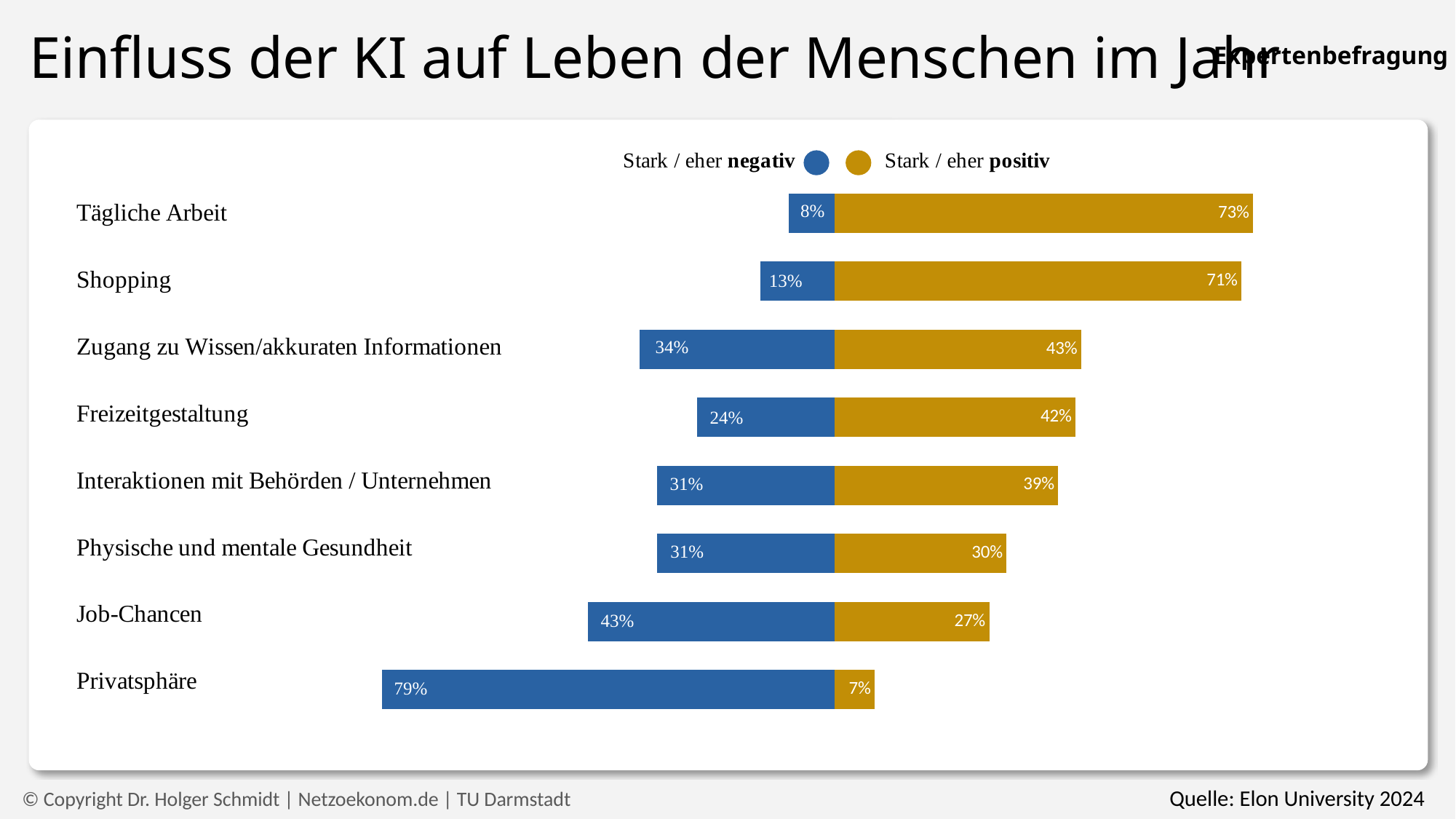
Which category has the lowest 'Stark / eher negativ' value? Tägliche Arbeit What is the 'Stark / eher positiv' value for Tägliche Arbeit? 73% What is the difference between the 'Stark / eher negativ' and 'Stark / eher positiv' values for Job-Chancen? 16% How many categories are shown in the chart? 8 What kind of chart is shown on the slide? Bar chart Which category has the lowest 'Stark / eher positiv' value? Privatsphäre Which is larger for Freizeitgestaltung: the 'Stark / eher negativ' value or the 'Stark / eher positiv' value? Stark / eher positiv What is the 'Stark / eher negativ' value for Zugang zu Wissen/akkuraten Informationen? 34% How many series does the legend list? 2 Which category has the highest 'Stark / eher positiv' value? Tägliche Arbeit What is the 'Stark / eher negativ' value for Privatsphäre? 79% Which colour represents 'Stark / eher positiv' in the chart? Gold